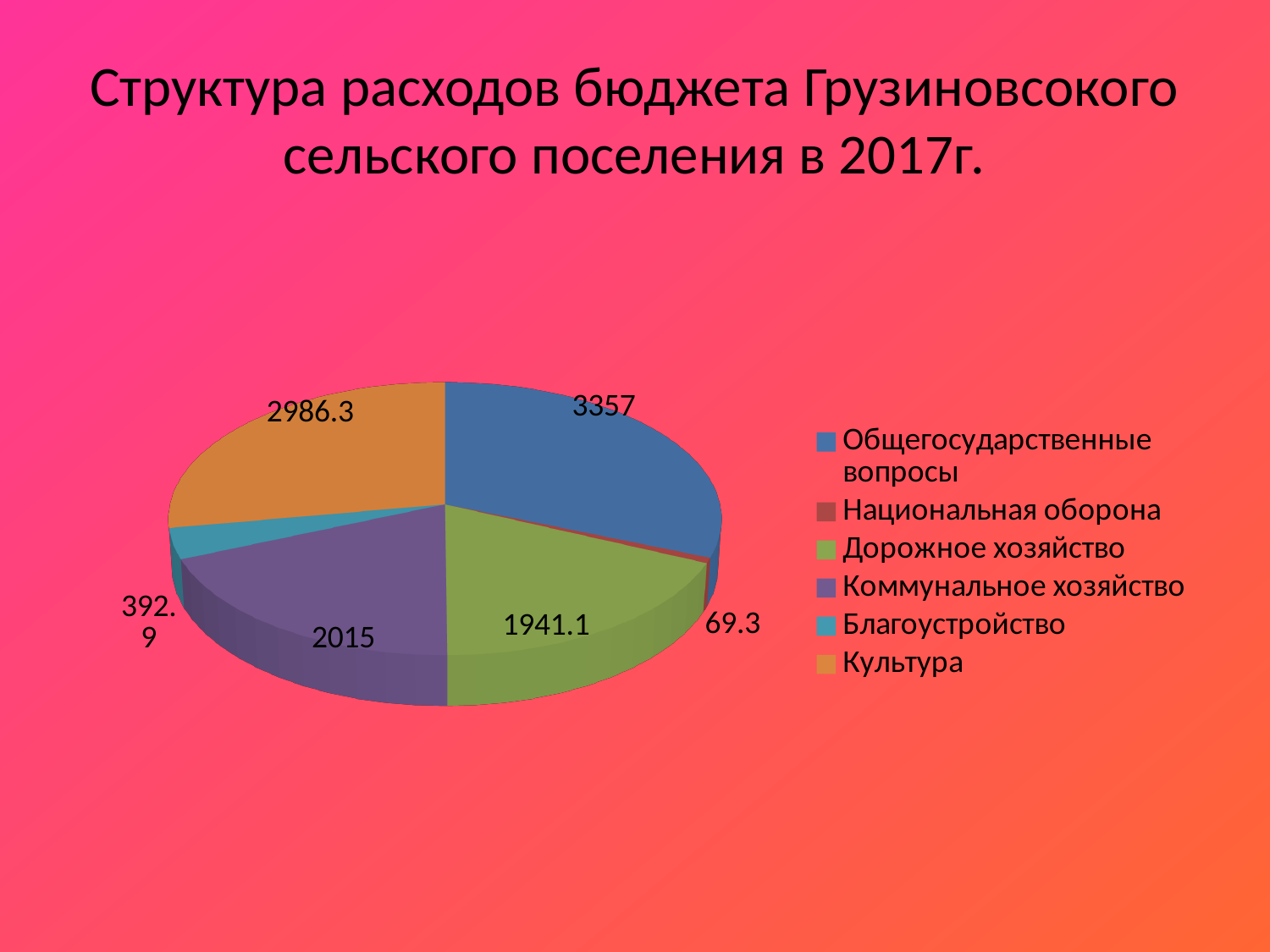
What is the value for Культура? 2986.3 What is the value for Национальная оборона? 69.3 What is the difference between the values for Коммунальное хозяйство and Дорожное хозяйство? 73.9 What is the title of the chart slide? Структура расходов бюджета Грузиновсокого сельского поселения в 2017г. What type of chart is shown on the slide? Pie chart What is the value for Благоустройство? 392.9 Which category has the smallest value? Национальная оборона What is the value for Общегосударственные вопросы? 3357 Which category has the largest value? Общегосударственные вопросы What is the difference between the values for Общегосударственные вопросы and Культура? 370.7 Which is larger, the value for Коммунальное хозяйство or the value for Дорожное хозяйство? Коммунальное хозяйство How many categories does the legend list? 6